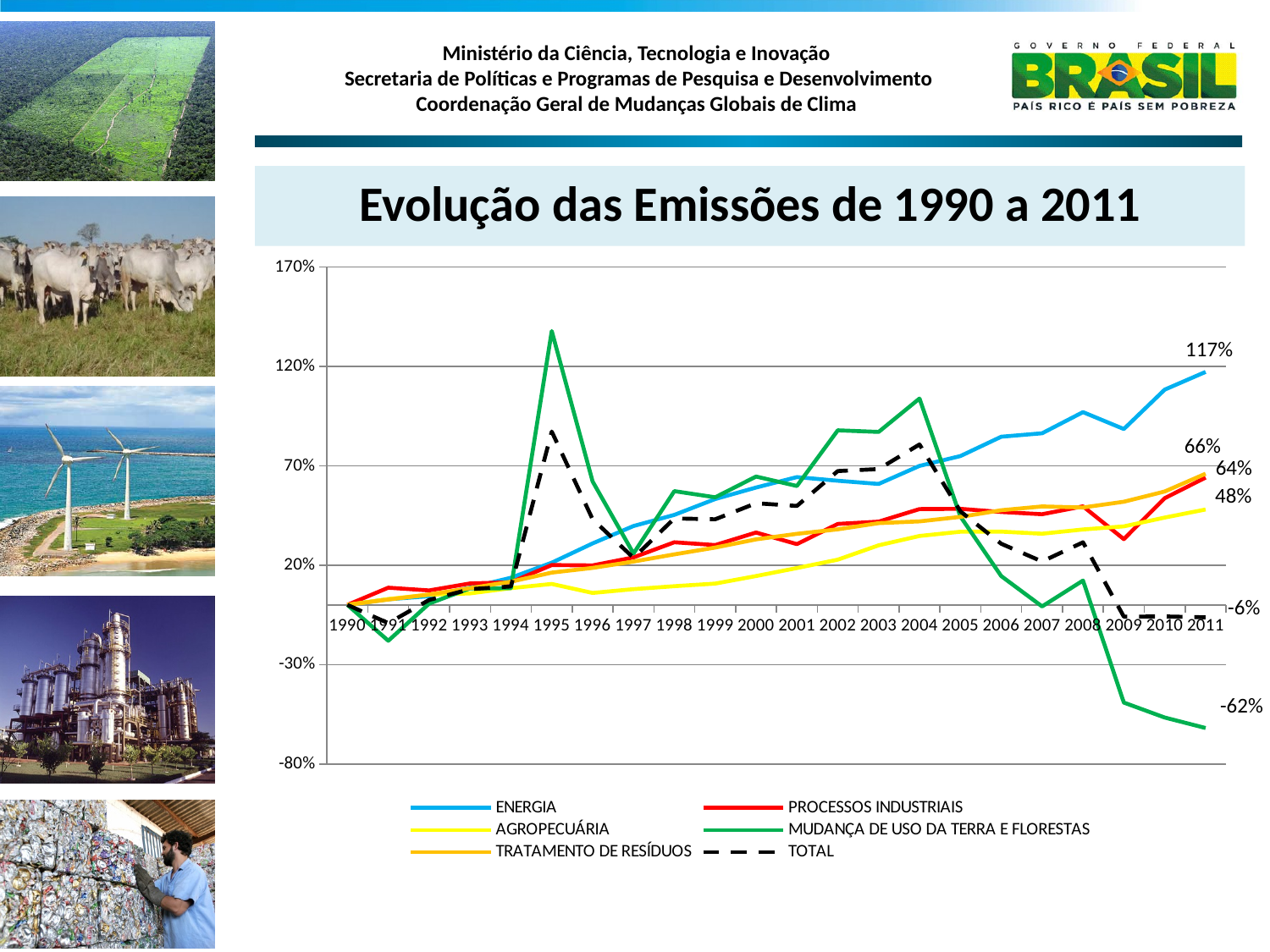
How many series does the chart legend list? 6 What is the difference between the 2011 values for ENERGIA and MUDANÇA DE USO DA TERRA E FLORESTAS? 179 percentage points What is the value for AGROPECUÁRIA in 2011? 48% How many years are plotted along the x axis? 22 Which series has the highest value in 2011? ENERGIA What is the value for MUDANÇA DE USO DA TERRA E FLORESTAS in 2011? -62% What type of chart is shown on the slide? Line chart What is the title of the chart? Evolução das Emissões de 1990 a 2011 What is the value for TOTAL in 2011? -6% What is the value for ENERGIA in 2011? 117% Which series has the lowest value in 2011? MUDANÇA DE USO DA TERRA E FLORESTAS Is the value for MUDANÇA DE USO DA TERRA E FLORESTAS in 1995 greater or less than 120%? greater